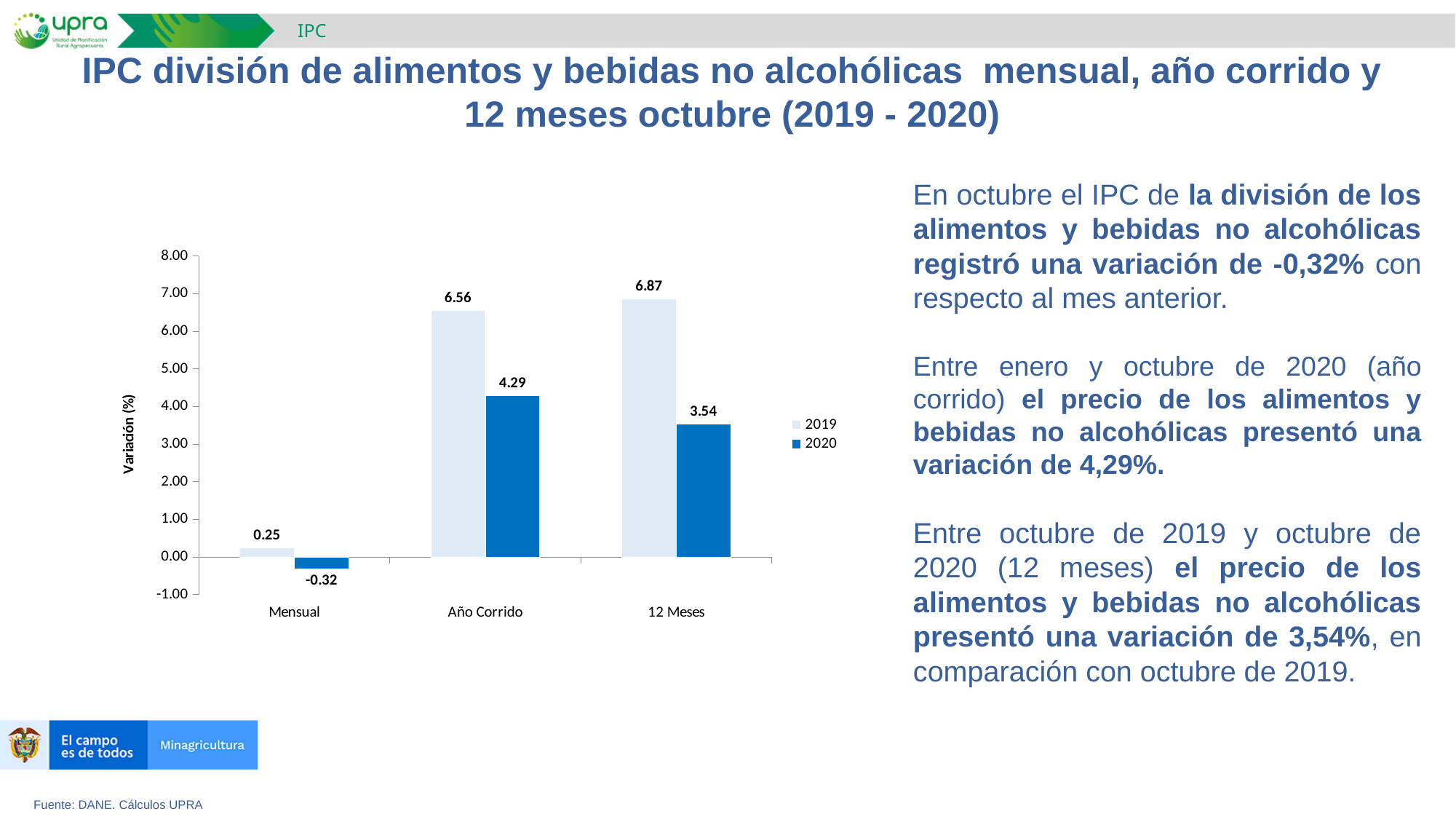
Which is larger in the 12 Meses category, the 2019 value or the 2020 value? 2019 What kind of chart is shown on the slide? Bar chart How many series does the legend list? 2 What is the value for 2019 in the Año Corrido category? 6.56 What is the label of the vertical axis? Variación (%) What is the value for 2020 in the Mensual category? -0.32 What is the difference between the 2019 and 2020 values in the Año Corrido category? 2.27 What is the value for 2019 in the Mensual category? 0.25 Which category has the highest value for the 2019 series? 12 Meses Which category has the lowest value for the 2020 series? Mensual How many categories are shown on the x axis? 3 What is the value for 2020 in the 12 Meses category? 3.54